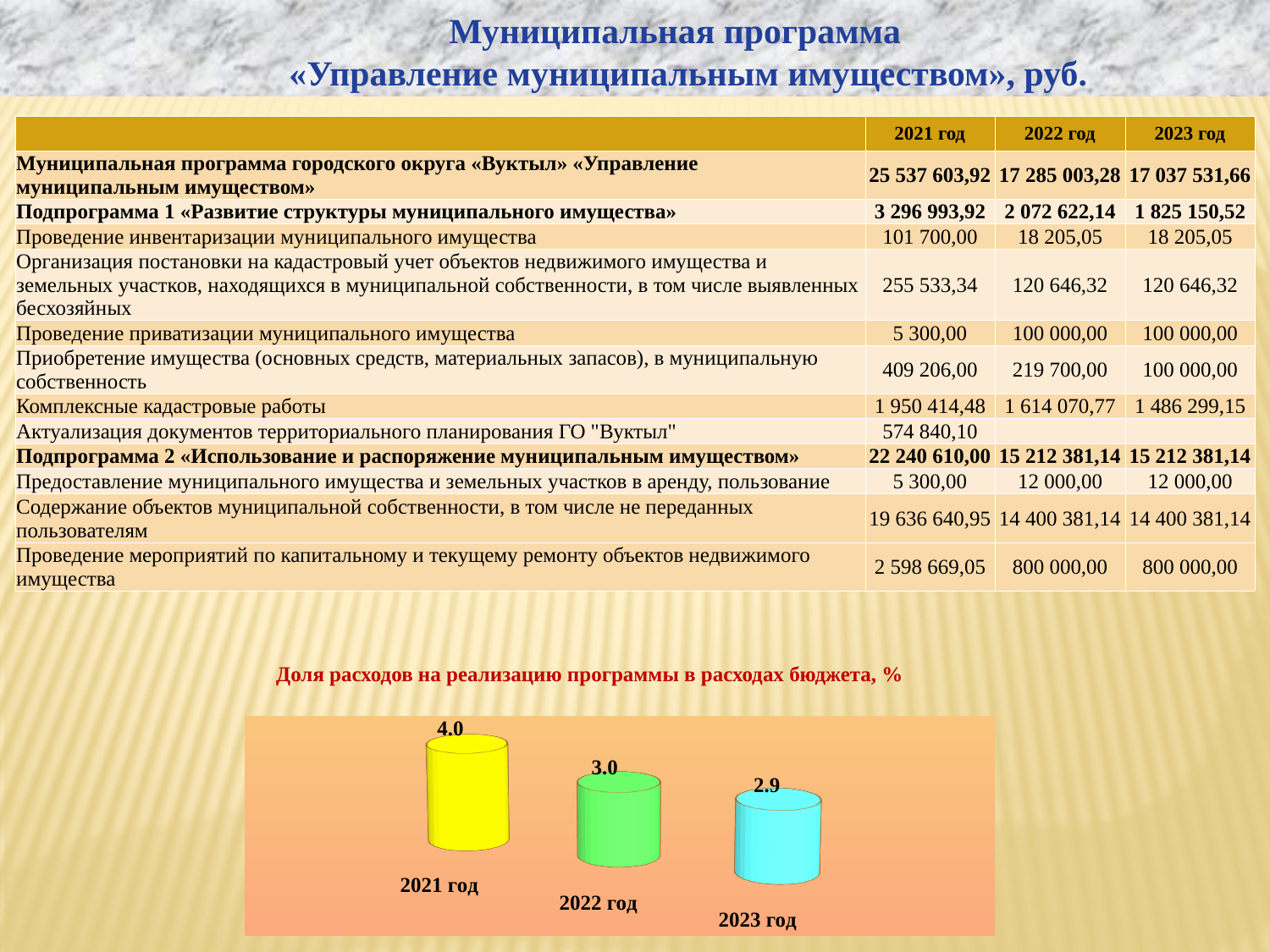
What is the difference between the values for 2021 год and 2023 год in the chart? 1.1 What kind of chart is shown at the bottom of the slide? bar chart Which is larger in the chart, the value for 2021 год or the value for 2022 год? 2021 год What is the value shown for 2022 год in the chart? 3.0 What is the value shown for 2021 год in the chart? 4.0 Which year has the highest value in the chart? 2021 год What is the difference between the values for 2021 год and 2022 год in the chart? 1.0 What is the title of the chart? Доля расходов на реализацию программы в расходах бюджета, % What is the value shown for 2023 год in the chart? 2.9 Which year has the lowest value in the chart? 2023 год How many categories are plotted in the chart? 3 Do the values in the chart rise or fall from 2021 год to 2023 год? fall